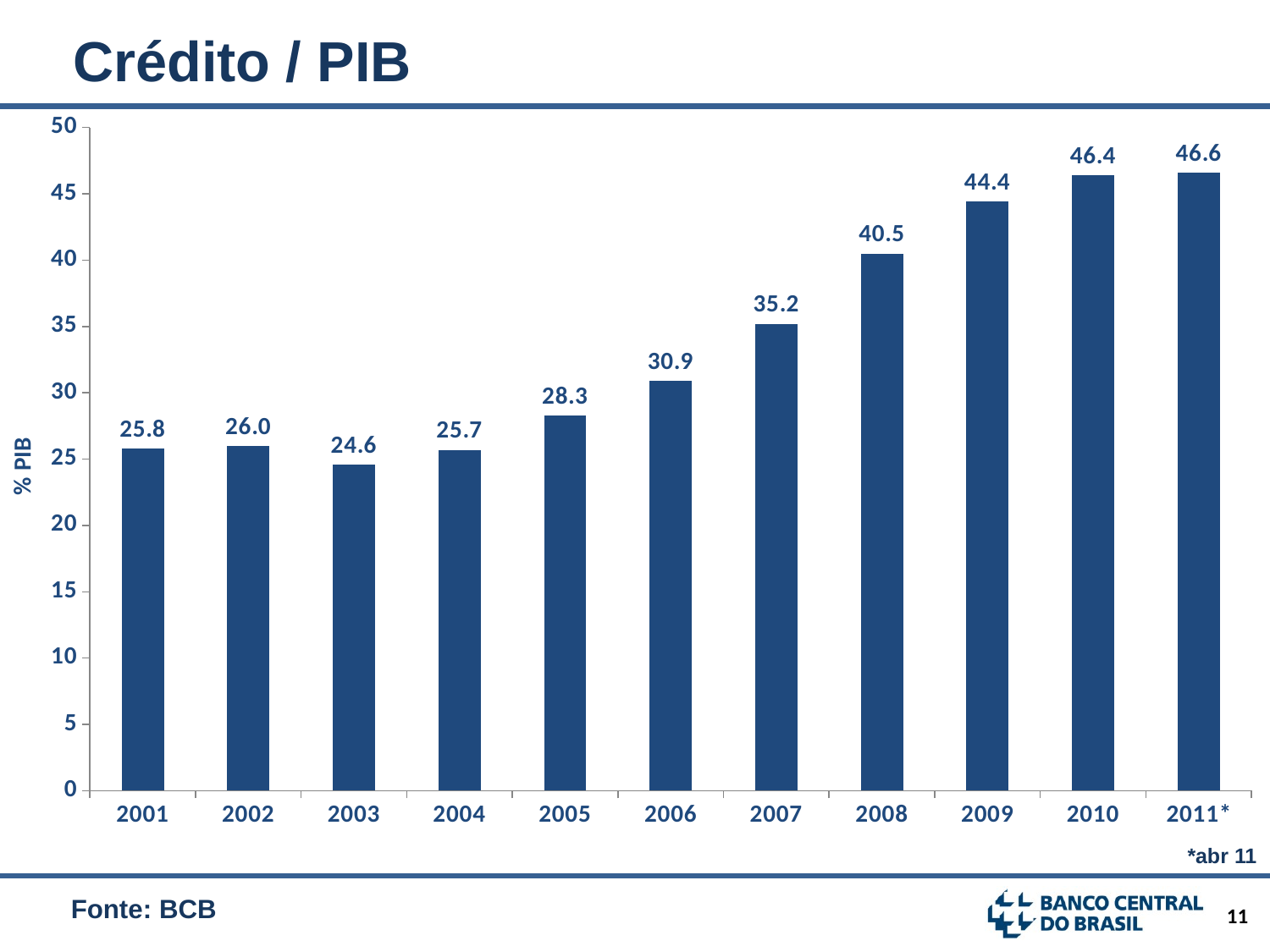
Which year has the highest value? 2011* What is the difference between the values for 2010 and 2009? 2.0 Which is larger, the value for 2006 or the value for 2007? 2007 Do the values generally rise or fall from 2004 to 2011*? rise What is the value for 2003? 24.6 What is the value for 2008? 40.5 What kind of chart is shown? bar chart What is the value for 2011*? 46.6 How many years are shown on the x axis? 11 Which year has the lowest value? 2003 What is the label of the y axis? % PIB Is the value for 2005 greater or less than 30? less